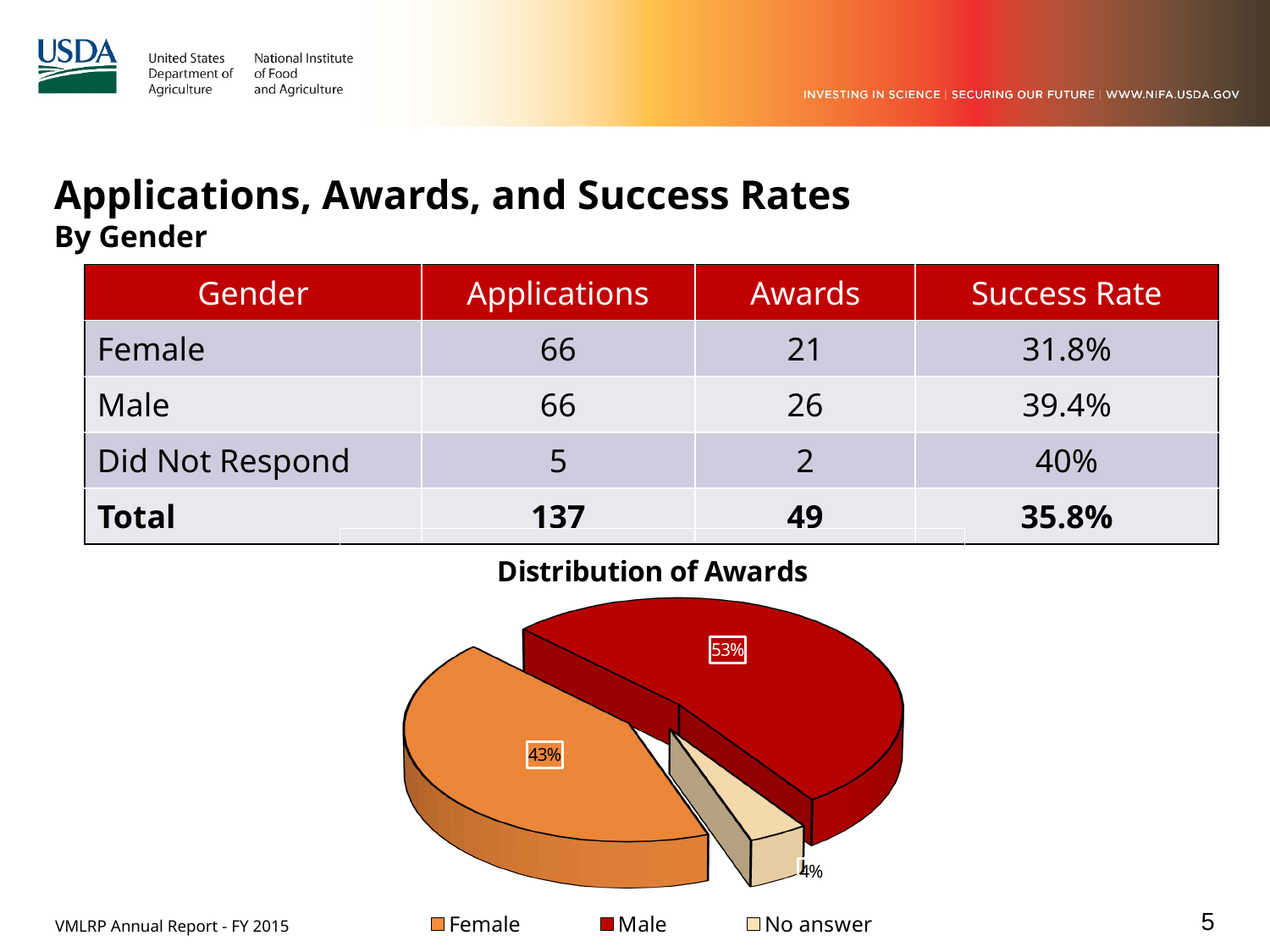
What is the title of the chart on the slide? Distribution of Awards In the Distribution of Awards pie chart, what percentage of awards went to Female? 43% How many entries does the legend of the Distribution of Awards pie chart list? 3 In the Distribution of Awards pie chart, what percentage of awards went to Male? 53% In the Distribution of Awards pie chart, which slice is larger, Female or Male? Male Which category has the smallest slice in the Distribution of Awards pie chart? No answer Which category has the largest slice in the Distribution of Awards pie chart? Male How many slices does the Distribution of Awards pie chart have? 3 What colour is the Female slice in the Distribution of Awards pie chart? orange In the Distribution of Awards pie chart, by how many percentage points does the Male share exceed the Female share? 10 percentage points In the Distribution of Awards pie chart, what percentage is labelled for No answer? 4% What type of chart is shown under the title "Distribution of Awards"? pie chart